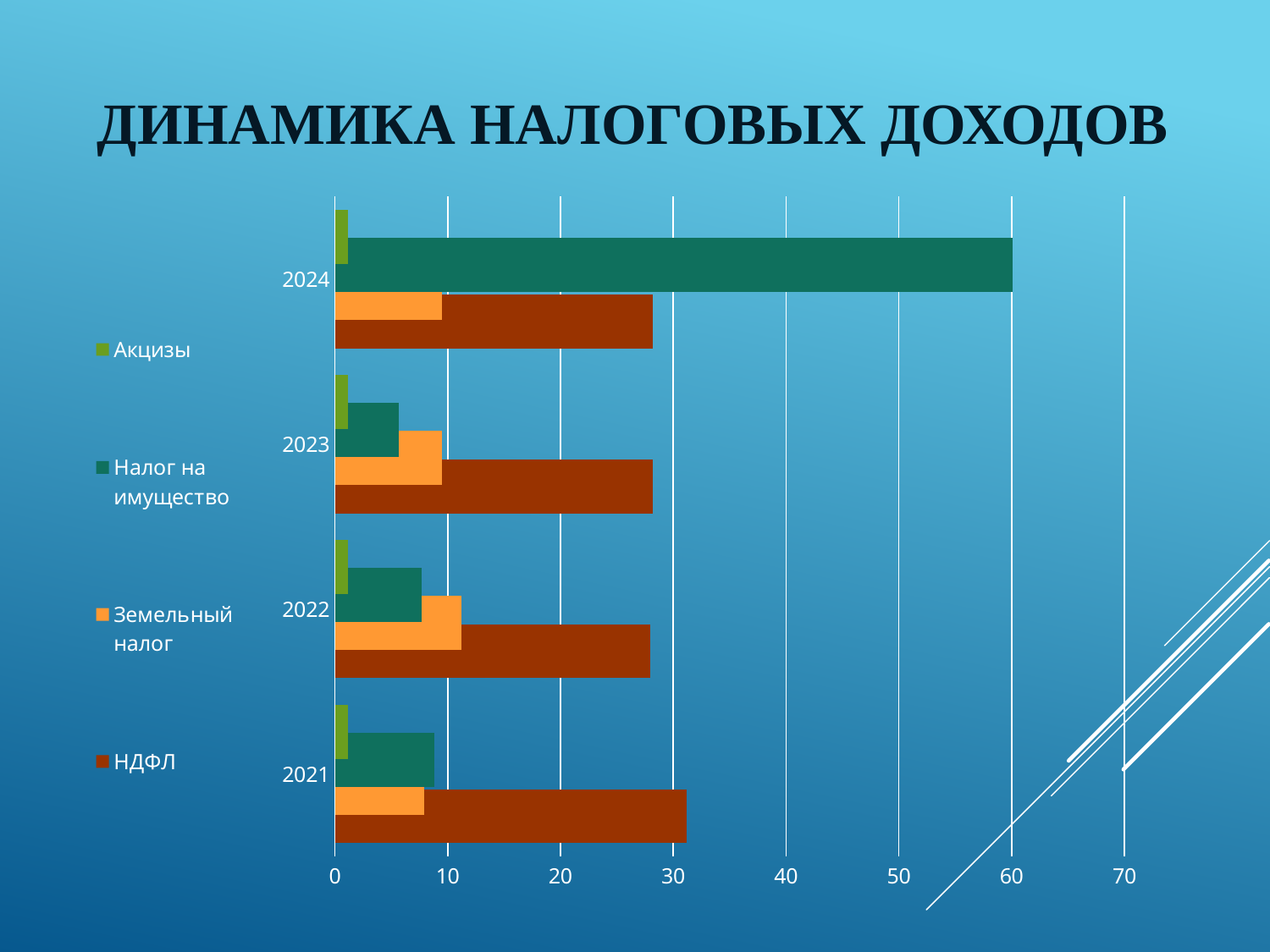
Is the value for НДФЛ in 2024 greater or less than 30? less Is the value for НДФЛ in 2021 greater or less than 30? greater In which year is the value for Налог на имущество the highest? 2024 How many series does the legend list? 4 Is the value for Налог на имущество in 2024 greater or less than 50? greater Which series has the smallest value in 2024? Акцизы What kind of chart is shown on the slide? Bar chart In which year is the value for НДФЛ the highest? 2021 Does the value for Налог на имущество rise or fall from 2021 to 2023? fall What is the title of the chart? ДИНАМИКА НАЛОГОВЫХ ДОХОДОВ In 2022, which is larger: Земельный налог or Налог на имущество? Земельный налог How many years are shown on the chart? 4